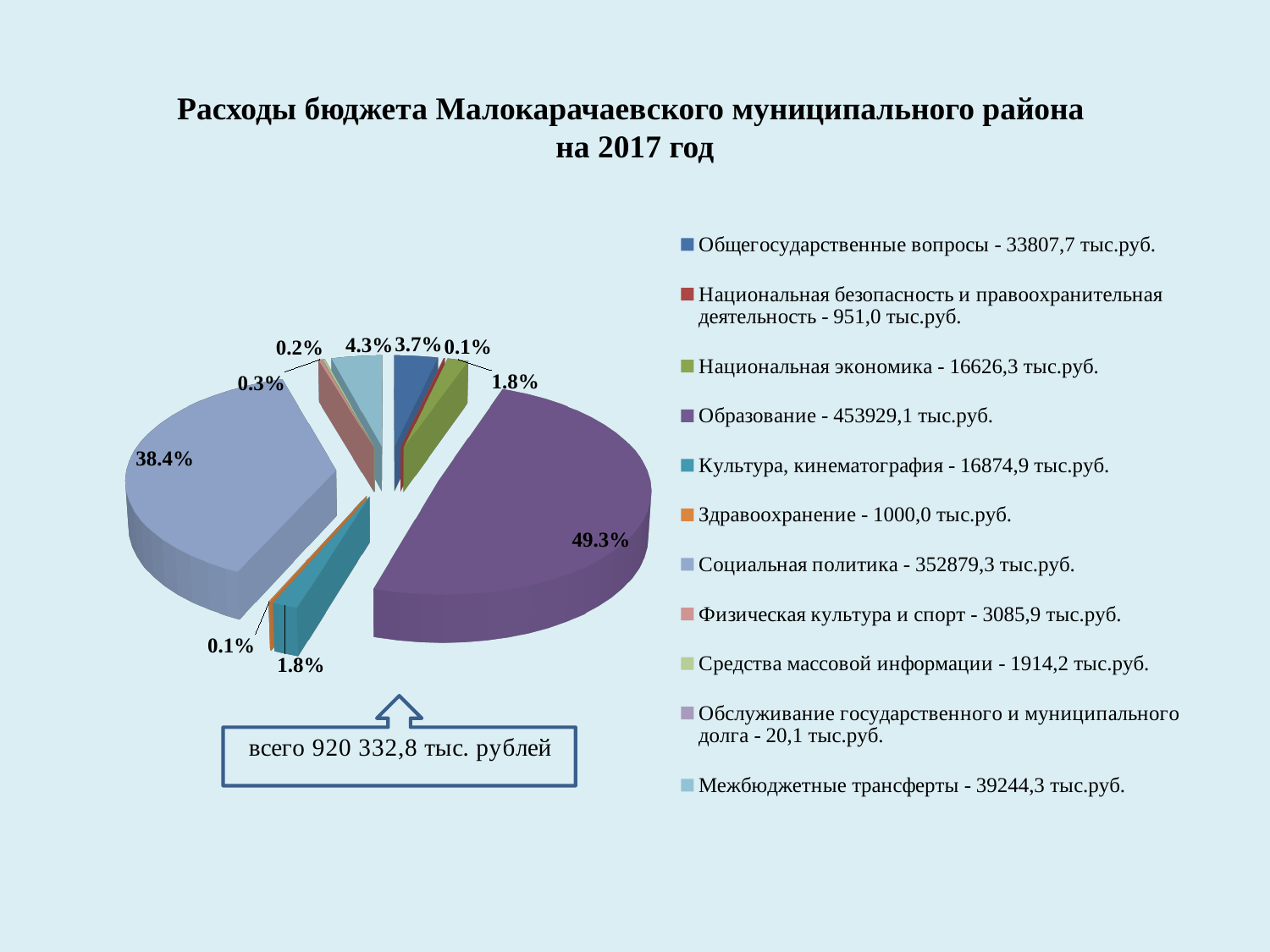
What is the difference between Культура, кинематография and Национальная экономика in тыс.руб.? 248,6 тыс.руб. Which is larger: Межбюджетные трансферты or Общегосударственные вопросы? Межбюджетные трансферты What share of the pie does Образование take? 49.3% What kind of chart is shown on the slide? pie chart What share of the pie does Социальная политика take? 38.4% Which category has the smallest value in the legend? Обслуживание государственного и муниципального долга How many expenditure categories does the legend list? 11 What is the value for Образование according to the legend? 453929,1 тыс.руб. What is the value for Здравоохранение according to the legend? 1000,0 тыс.руб. What is the value for Социальная политика according to the legend? 352879,3 тыс.руб. Which category has the largest share of the budget expenditures? Образование What total expenditure amount is shown in the box below the chart? 920 332,8 тыс. рублей